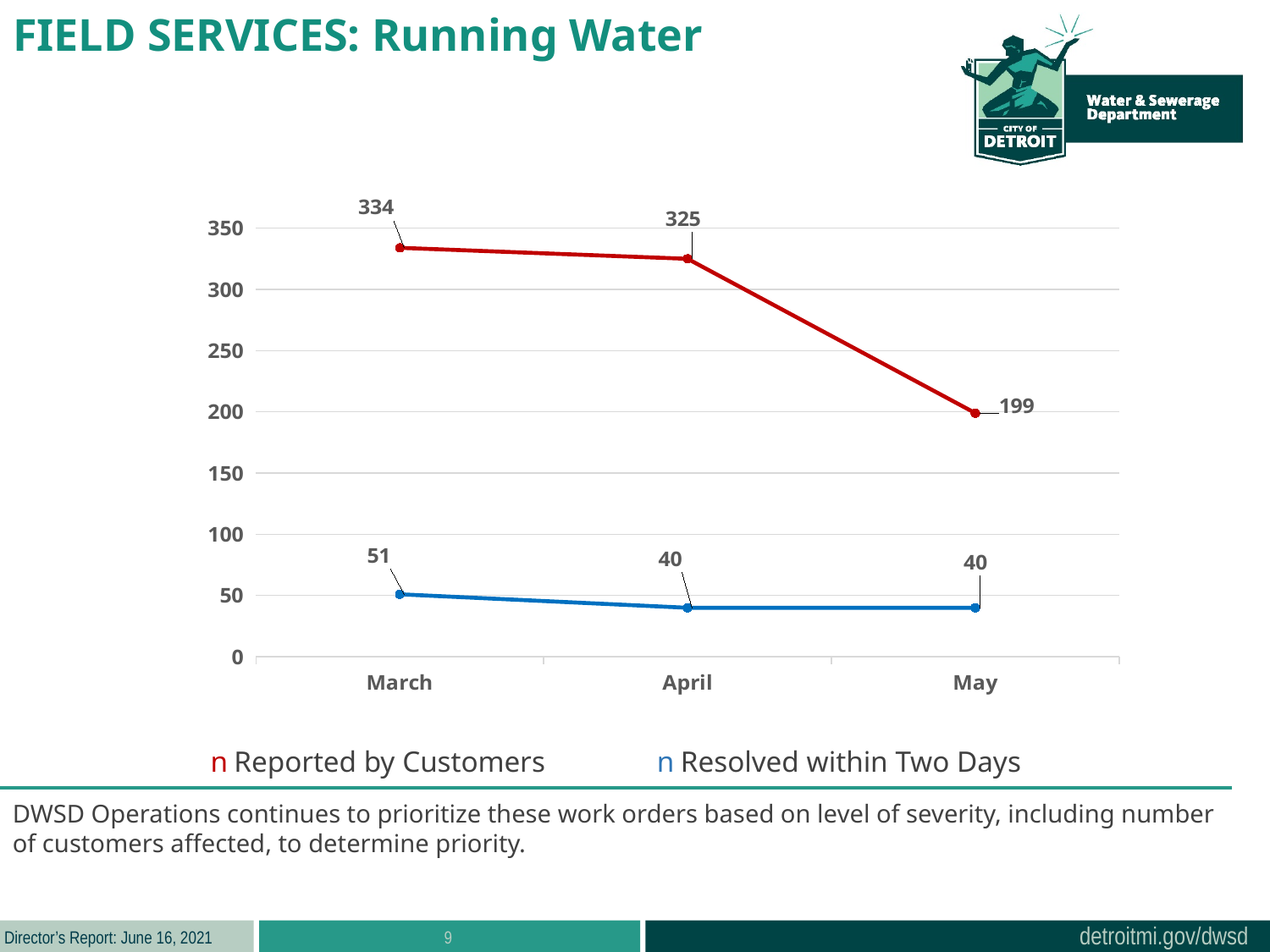
Which series is drawn in red? Reported by Customers What type of chart is shown on the slide? Line chart What is the value for Resolved within Two Days in March? 51 In which month is Reported by Customers lowest? May Does Reported by Customers rise or fall from March to May? Fall What is the difference between Reported by Customers in April and in May? 126 What is the value for Resolved within Two Days in April? 40 What is the value for Reported by Customers in March? 334 How many series does the legend list? 2 What is the value for Reported by Customers in May? 199 How many months are plotted on the x axis? 3 In which month is Reported by Customers highest? March